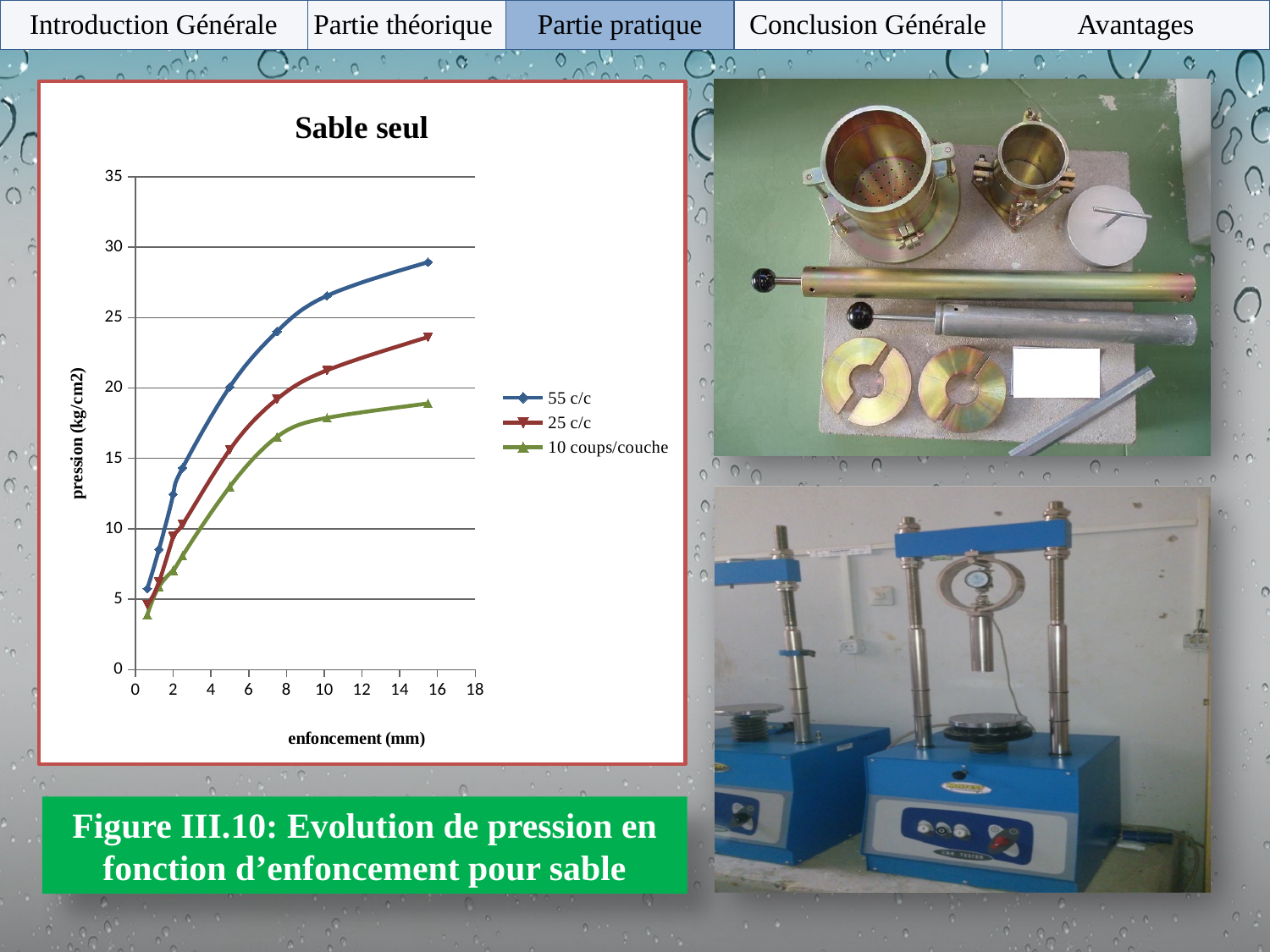
In the "Sable seul" chart, at the largest enfoncement, which series has the larger pressure: 55 c/c or 10 coups/couche? 55 c/c What is the title of the chart on the left of the slide? Sable seul In the "Sable seul" chart, is the final pressure value of the 10 coups/couche series greater or less than 25? less How many series does the legend of the "Sable seul" chart list? 3 In the "Sable seul" chart, do the values of the 55 c/c series rise or fall as enfoncement increases? rise In the "Sable seul" chart, is the final pressure value of the 25 c/c series greater or less than 20? greater In the "Sable seul" chart, which series has the lowest pressure at the largest enfoncement? 10 coups/couche What kind of chart is shown under the title "Sable seul"? line chart In the "Sable seul" chart, which series reaches the highest pressure? 55 c/c What is the label of the x axis of the "Sable seul" chart? enfoncement (mm) In the "Sable seul" chart, is the final pressure value of the 55 c/c series greater or less than 25? greater